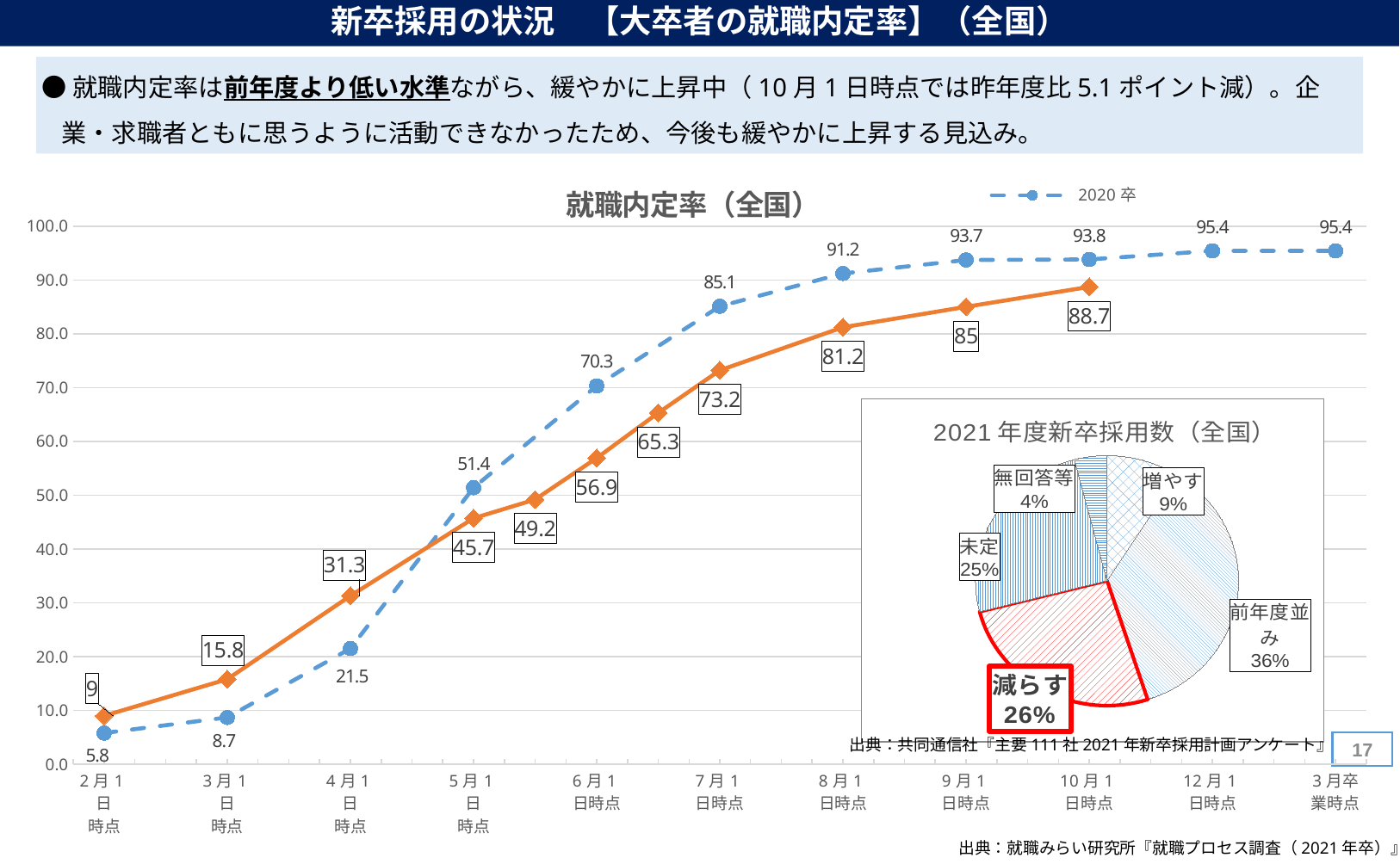
How many slices does the pie chart 2021年度新卒採用数（全国） have? 5 In the pie chart 2021年度新卒採用数（全国）, which category has the largest share? 前年度並み In the line chart 就職内定率（全国）, what is the 2020卒 value at 8月1日時点? 91.2 In the pie chart 2021年度新卒採用数（全国）, what share of companies answered 減らす? 26% In the pie chart 2021年度新卒採用数（全国）, what is the share for 未定? 25% In the line chart 就職内定率（全国）, what is the value of the orange solid line at 10月1日時点? 88.7 What kind of chart is 就職内定率（全国）? line chart In the pie chart 2021年度新卒採用数（全国）, which category has the smallest share? 無回答等 In the line chart 就職内定率（全国）, at 4月1日時点, which is larger: the 2020卒 value or the orange solid line value? the orange solid line In the line chart 就職内定率（全国）, does the 2020卒 series rise or fall from 2月1日 to 3月卒業時点? rise In the line chart 就職内定率（全国）, what is the 2020卒 value at 2月1日時点? 5.8 In the line chart 就職内定率（全国）, what is the difference between the 2020卒 value and the orange solid line value at 10月1日時点? 5.1